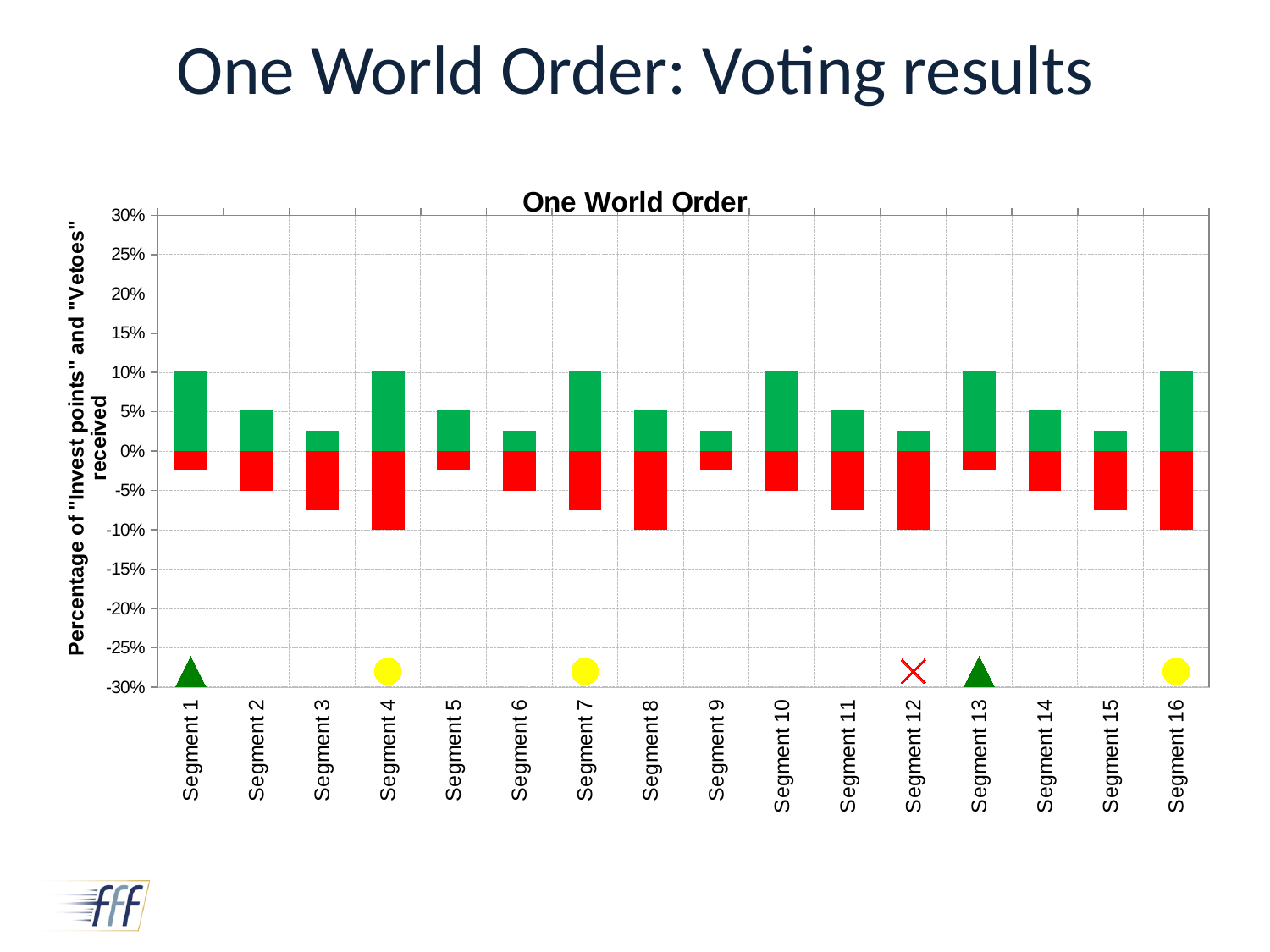
How many segments are shown along the x axis of the chart? 16 Is the red bar for Segment 3 greater or less than -5%? less Which green bar is taller, Segment 1 or Segment 2? Segment 1 What is the y-axis label of the chart? Percentage of "Invest points" and "Vetoes" received What value does the red bar for Segment 4 reach? -10% What kind of chart is shown on the slide? bar chart Is the green bar for Segment 3 greater or less than 5%? less What value does the red bar for Segment 10 reach? -5% What is the title of the chart? One World Order Which red bar extends further below zero, Segment 8 or Segment 9? Segment 8